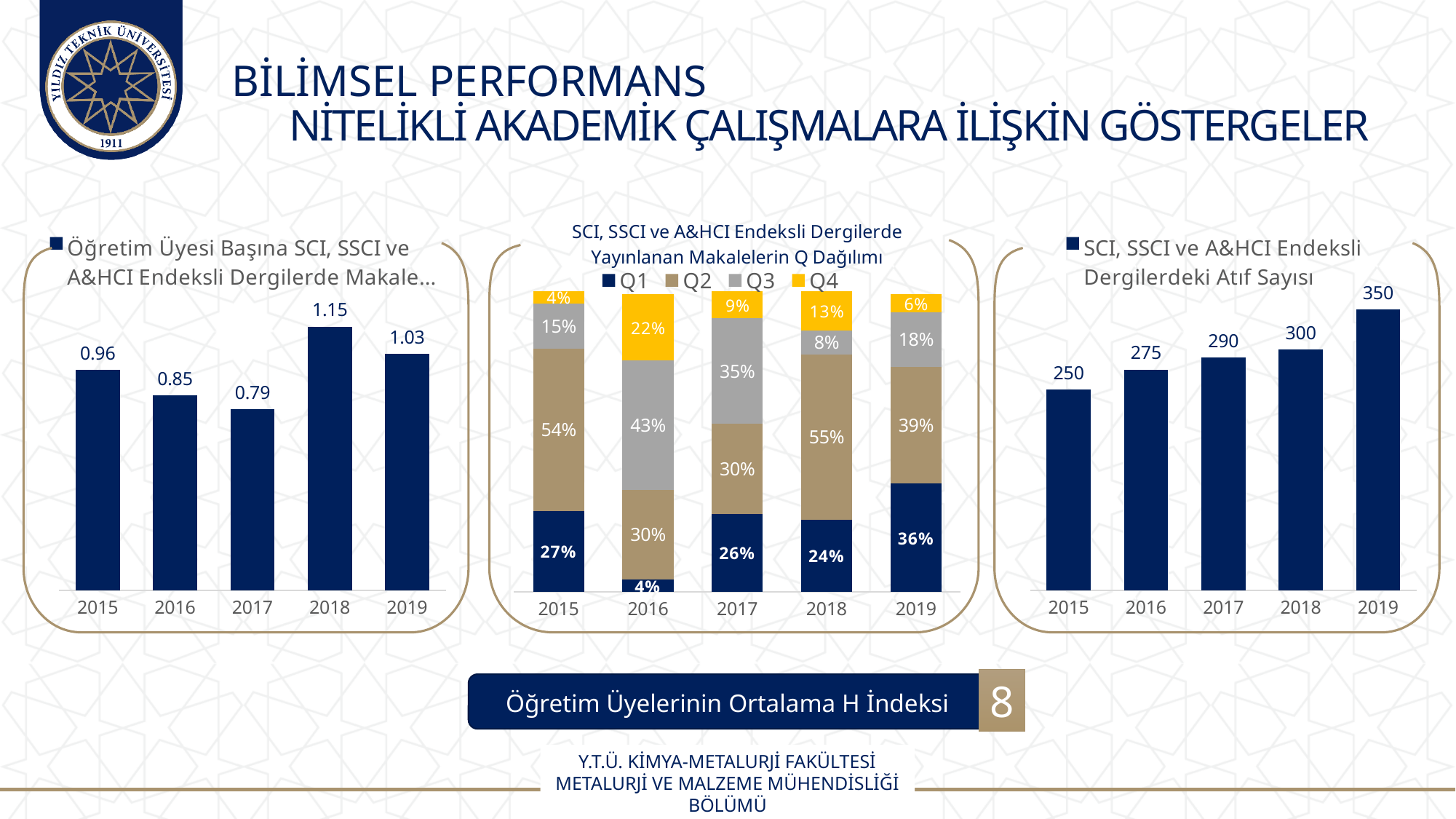
In the right chart (SCI, SSCI ve A&HCI Endeksli Dergilerdeki Atıf Sayısı), what is the value for 2017? 290 In the left chart (Öğretim Üyesi Başına SCI, SSCI ve A&HCI Endeksli Dergilerde Makale...), which year has the lowest value? 2017 What kind of chart is the right chart (SCI, SSCI ve A&HCI Endeksli Dergilerdeki Atıf Sayısı)? bar chart In the right chart (SCI, SSCI ve A&HCI Endeksli Dergilerdeki Atıf Sayısı), what is the difference between the 2019 and 2015 values? 100 In the middle chart (SCI, SSCI ve A&HCI Endeksli Dergilerde Yayınlanan Makalelerin Q Dağılımı), which year has the lowest Q1 share? 2016 In the middle chart (SCI, SSCI ve A&HCI Endeksli Dergilerde Yayınlanan Makalelerin Q Dağılımı), what is the Q1 share for 2019? 36% In the left chart (Öğretim Üyesi Başına SCI, SSCI ve A&HCI Endeksli Dergilerde Makale...), what is the value for 2018? 1.15 In the middle chart (SCI, SSCI ve A&HCI Endeksli Dergilerde Yayınlanan Makalelerin Q Dağılımı), how many series does the legend list? 4 In the middle chart (SCI, SSCI ve A&HCI Endeksli Dergilerde Yayınlanan Makalelerin Q Dağılımı), what is the Q4 share for 2016? 22% In the left chart (Öğretim Üyesi Başına SCI, SSCI ve A&HCI Endeksli Dergilerde Makale...), what is the difference between the 2018 and 2019 values? 0.12 In the right chart (SCI, SSCI ve A&HCI Endeksli Dergilerdeki Atıf Sayısı), do the values rise or fall from 2015 to 2019? rise In the middle chart (SCI, SSCI ve A&HCI Endeksli Dergilerde Yayınlanan Makalelerin Q Dağılımı), is the Q2 share larger in 2015 or in 2017? 2015